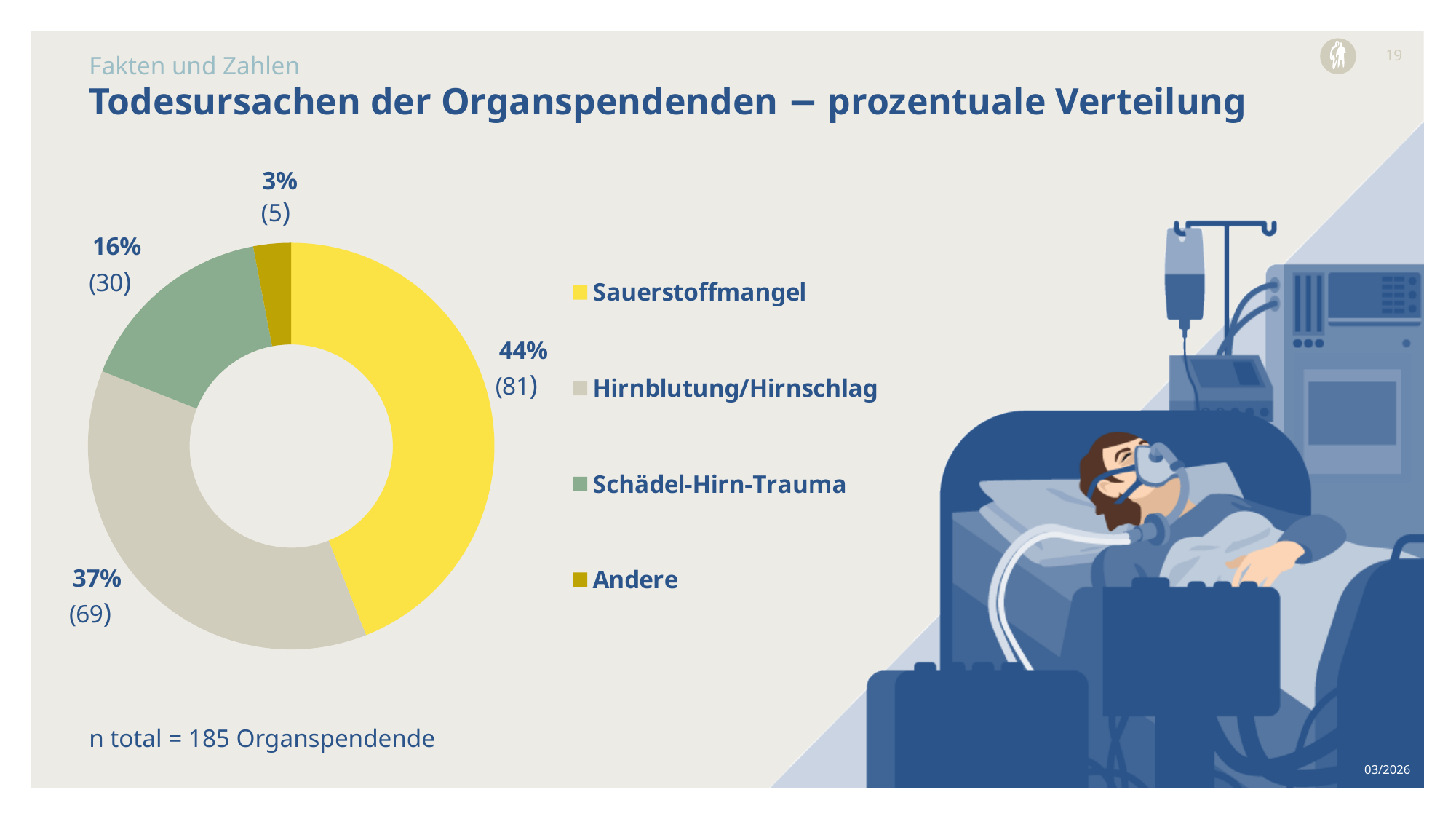
Which cause of death has the largest share? Sauerstoffmangel What percentage share does Schädel-Hirn-Trauma have? 16% Which cause of death has the smallest share? Andere What kind of chart is shown on the slide? Pie chart (donut) What is the difference in number of donors between Sauerstoffmangel and Hirnblutung/Hirnschlag? 12 How many organ donors fall under Andere? 5 Which has more donors, Schädel-Hirn-Trauma or Andere? Schädel-Hirn-Trauma How many categories does the chart show? 4 What percentage of the donut chart is Sauerstoffmangel? 44% How many organ donors are in the Hirnblutung/Hirnschlag category? 69 What is the total number of organ donors stated on the slide? 185 Which colour represents Hirnblutung/Hirnschlag in the chart? Light grey